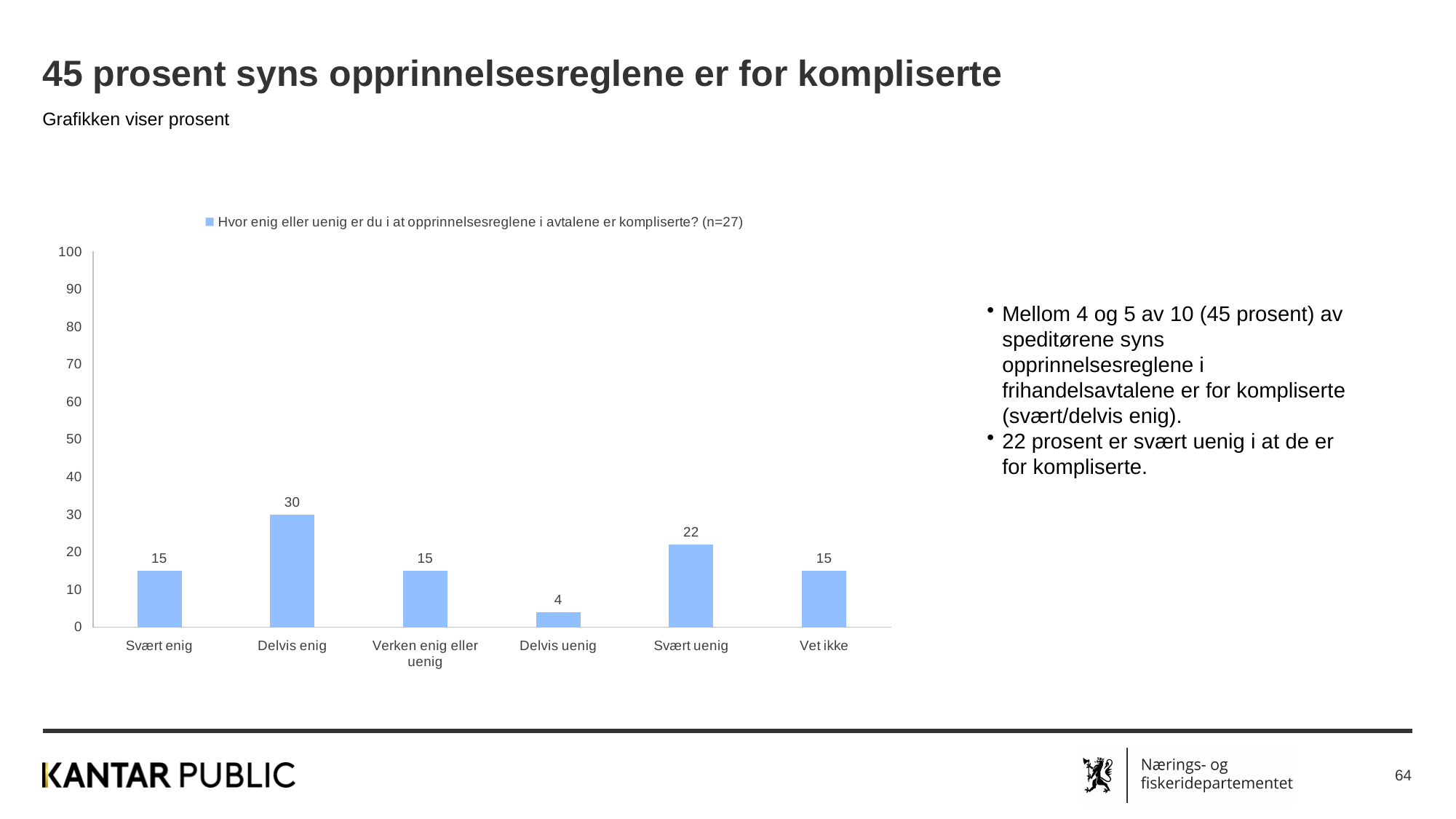
How many categories are shown on the x axis? 6 What is the value for "Svært uenig"? 22 What is the value for "Delvis enig"? 30 What is the sample size (n) given in the legend entry? 27 Which is larger, the value for "Svært uenig" or the value for "Svært enig"? Svært uenig What is the difference between the values for "Delvis enig" and "Svært uenig"? 8 Which category has the highest value? Delvis enig Which category has the lowest value? Delvis uenig Is the value for "Delvis enig" greater or less than 20? greater What is the value for "Delvis uenig"? 4 What is the value for "Vet ikke"? 15 What kind of chart is shown on the slide? Bar chart